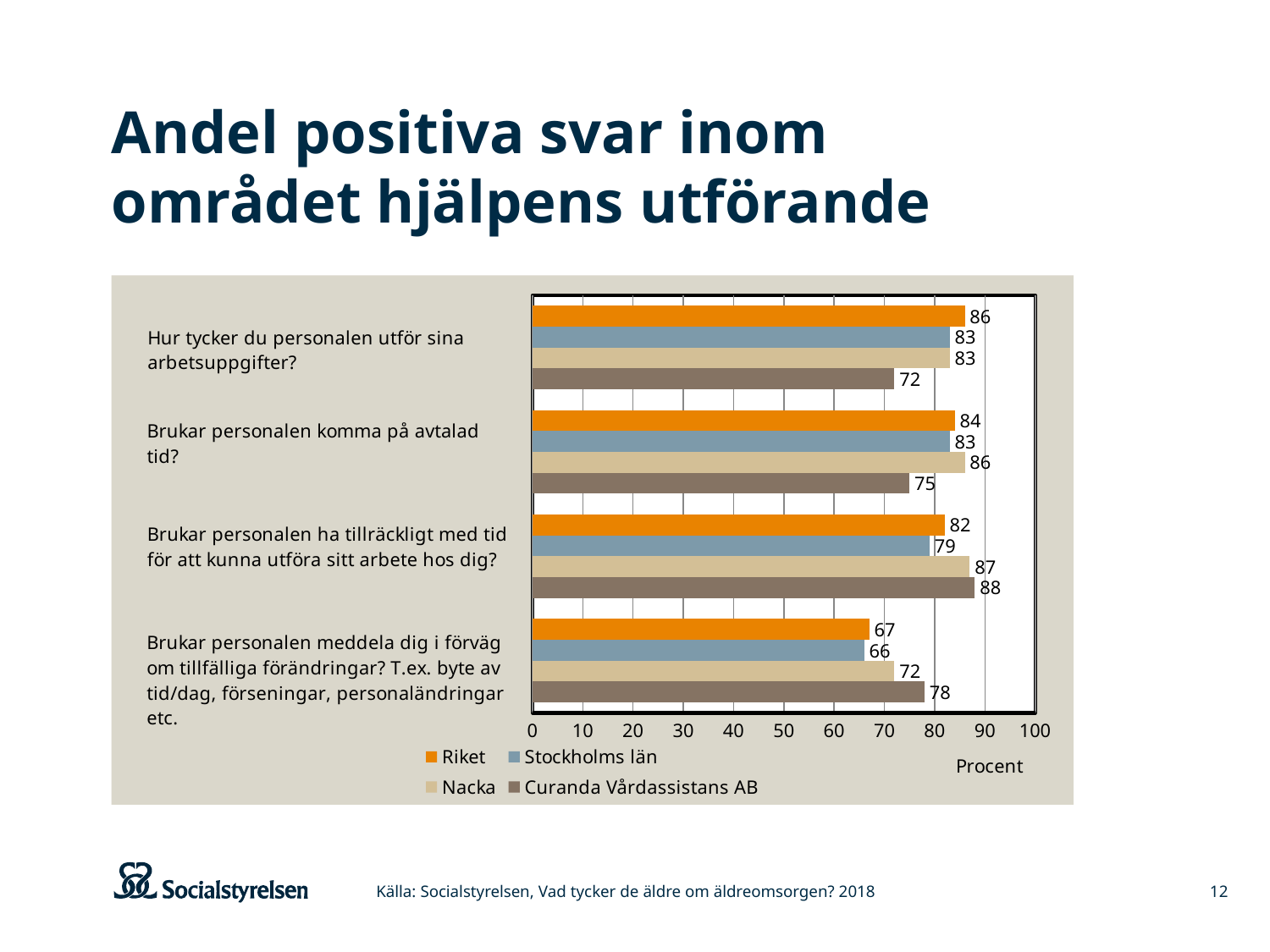
Which series has the highest value on the question "Brukar personalen ha tillräckligt med tid för att kunna utföra sitt arbete hos dig?"? Curanda Vårdassistans AB Which series has the lowest value on the question "Hur tycker du personalen utför sina arbetsuppgifter?"? Curanda Vårdassistans AB Is the value for Riket on the question "Brukar personalen meddela dig i förväg om tillfälliga förändringar?" greater or less than 70? less What is the value for Nacka on the question "Brukar personalen ha tillräckligt med tid för att kunna utföra sitt arbete hos dig?"? 87 What is the value for Riket on the question "Hur tycker du personalen utför sina arbetsuppgifter?"? 86 On the question "Brukar personalen meddela dig i förväg om tillfälliga förändringar?", which is larger: Nacka or Curanda Vårdassistans AB? Curanda Vårdassistans AB What is the value for Stockholms län on the question "Brukar personalen meddela dig i förväg om tillfälliga förändringar?"? 66 How many question categories are shown on the chart? 4 What is the value for Curanda Vårdassistans AB on the question "Brukar personalen komma på avtalad tid?"? 75 What is the difference between Riket and Curanda Vårdassistans AB on the question "Hur tycker du personalen utför sina arbetsuppgifter?"? 14 What kind of chart is shown on the slide? Bar chart How many series does the legend list? 4